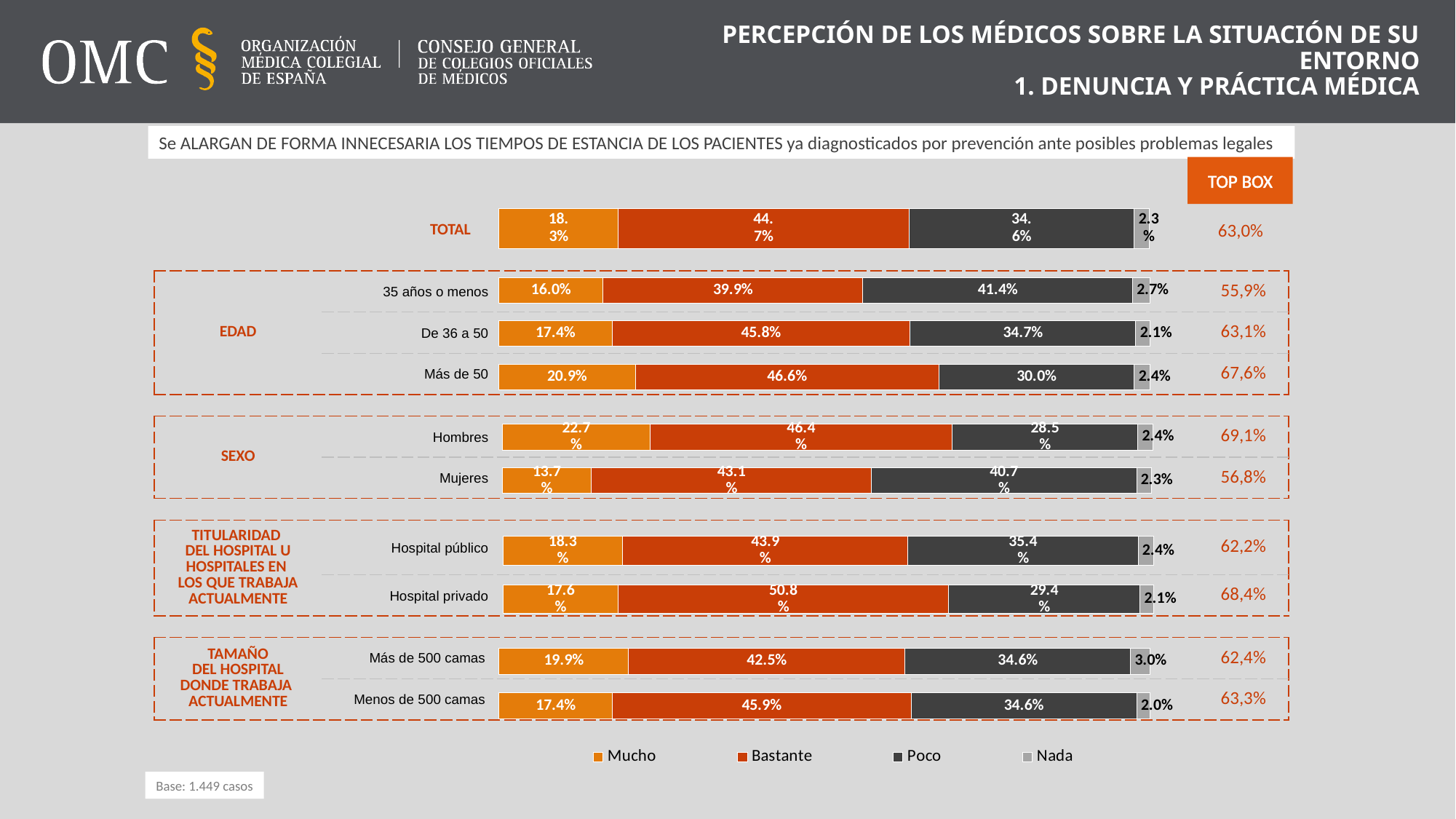
What is the difference between the Mucho values for Hombres and Mujeres? 9.0 percentage points Which category has the highest Bastante value? Hospital privado What is the value of the Poco segment for '35 años o menos'? 41.4% Which category has the lowest Mucho value? Mujeres How many bars (categories) are plotted in the chart, including TOTAL? 10 What is the value of the Mucho segment for the 'Más de 50' bar? 20.9% How many series does the legend list? 4 What is the TOP BOX value shown for Hombres? 69,1% What kind of chart is shown on the slide? Stacked bar chart Which has a larger Poco value, Hospital público or Hospital privado? Hospital público What is the value of the Nada segment for 'Más de 500 camas'? 3.0% What is the value of the Bastante segment for 'Hospital privado'? 50.8%